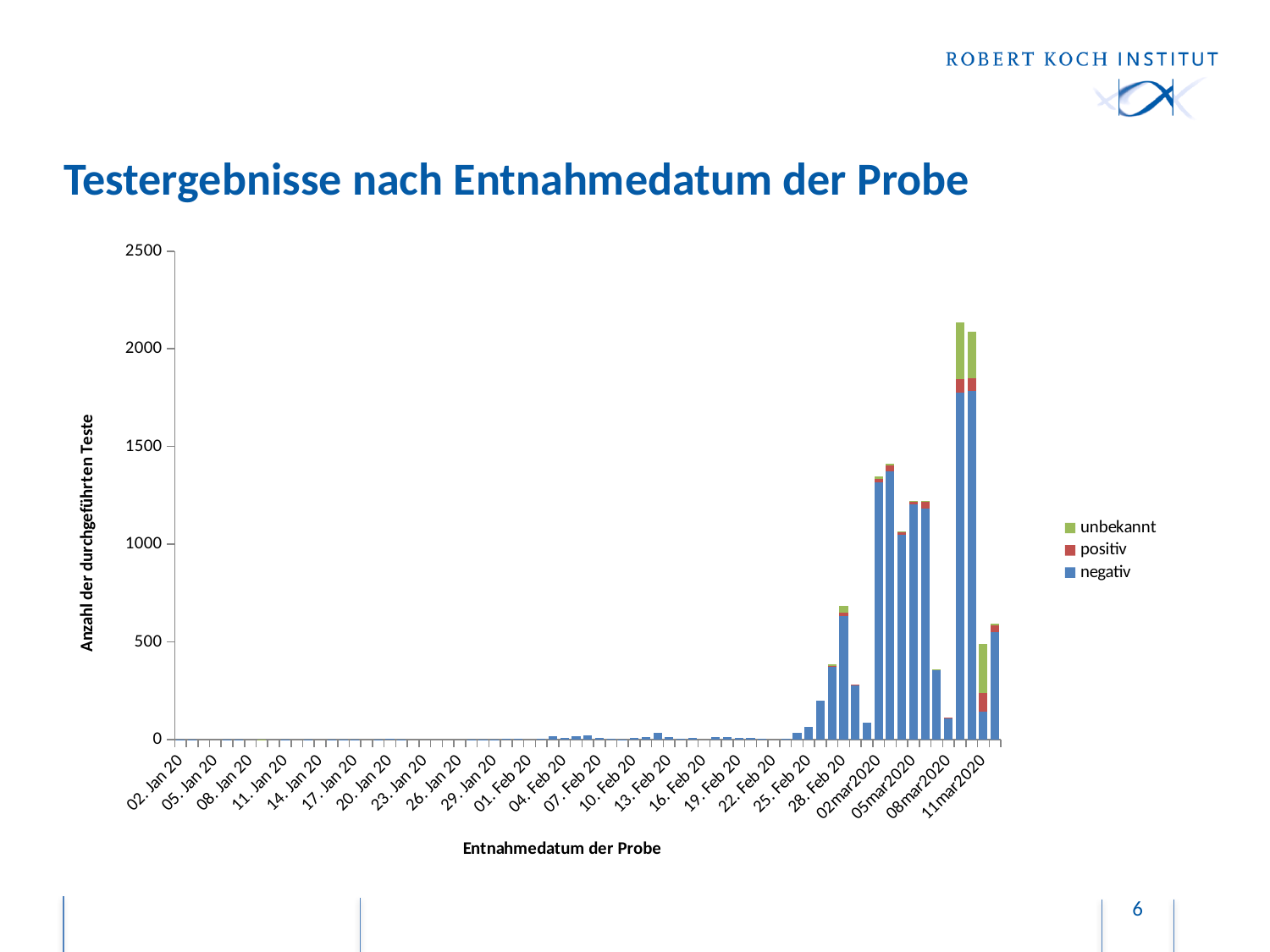
Is the value for 02. Jan 20 greater or less than 500? less Is the total value for 11mar2020 greater or less than 1000? less Do the tallest bars in the chart exceed 2000 tests? yes Which series is plotted at the bottom of each stacked bar? negativ How many series does the legend list? 3 Which series makes up the largest part of the tallest bars? negativ What kind of chart is shown on the slide? stacked bar chart What is the title of the chart? Testergebnisse nach Entnahmedatum der Probe Which series is shown in red in the legend? positiv Overall, do the number of tests rise or fall from January to March along the x axis? rise